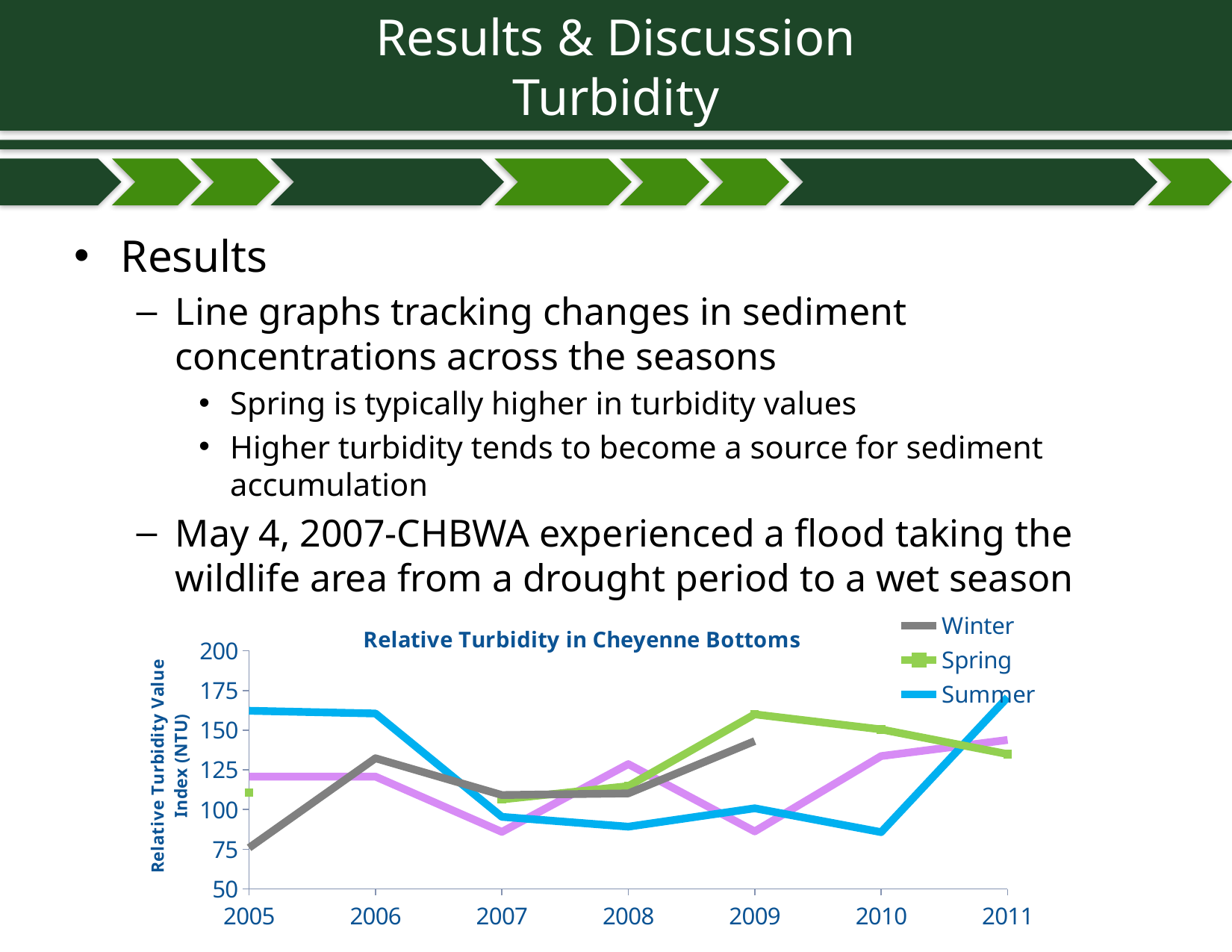
Is the Summer value for 2005 greater or less than 150? greater How many years are shown on the x axis of the chart? 7 What kind of chart is shown on the slide? line chart Is the Summer value for 2010 greater or less than 100? less What is the title of the chart? Relative Turbidity in Cheyenne Bottoms Does the Summer line rise or fall from 2005 to 2007? fall How many series does the chart's legend list? 3 Is the Summer value for 2011 greater or less than 150? greater Which is larger in 2005, the Summer value or the Winter value? Summer Does the Winter line rise or fall from 2007 to 2009? rise